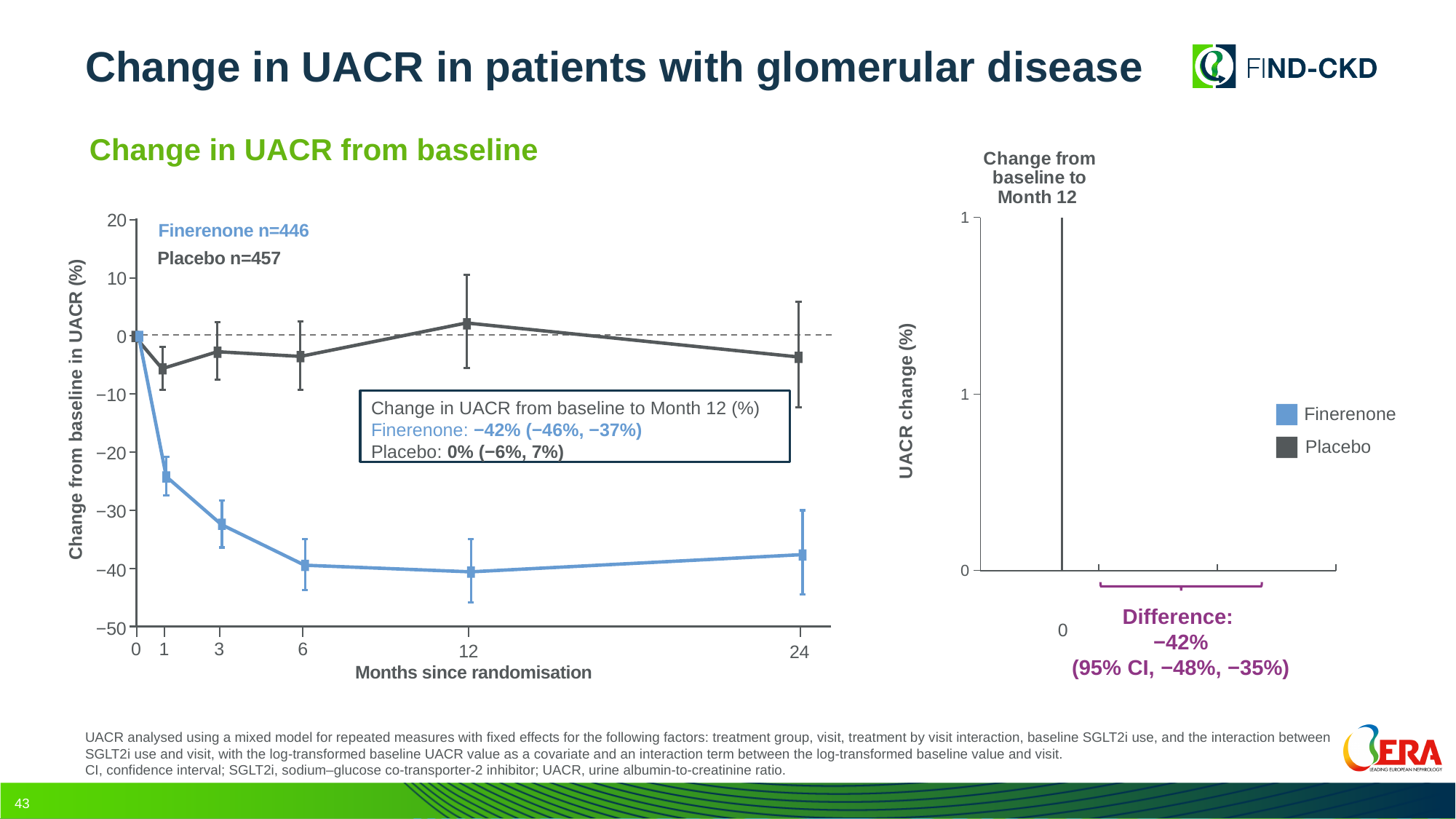
In the 'Change in UACR from baseline' chart, is the Finerenone value at Month 6 greater or less than −30? less In the 'Change in UACR from baseline' chart, what is the change in UACR from baseline to Month 12 for Finerenone? −42% In the 'Change in UACR from baseline' chart, what is the change in UACR from baseline to Month 12 for Placebo? 0% In the 'Change in UACR from baseline' chart, how many series are plotted? 2 In the 'Change in UACR from baseline' chart, is the Placebo value at Month 1 greater or less than −10? greater In the 'Change in UACR from baseline' chart, at which month does the Placebo series reach its highest value? 12 What kind of chart is the 'Change in UACR from baseline' chart on the left? line chart In the 'Change in UACR from baseline' chart, how many patients are in the Finerenone group? n=446 In the 'Change in UACR from baseline' chart, how many time points are labelled on the x axis? 6 In the 'Change in UACR from baseline' chart, which series has the lower value at Month 12, Finerenone or Placebo? Finerenone In the 'Change from baseline to Month 12' chart on the right, what is the difference between Finerenone and Placebo shown below the axis? −42% In the 'Change in UACR from baseline' chart, does the Finerenone series rise or fall between Month 0 and Month 6? fall